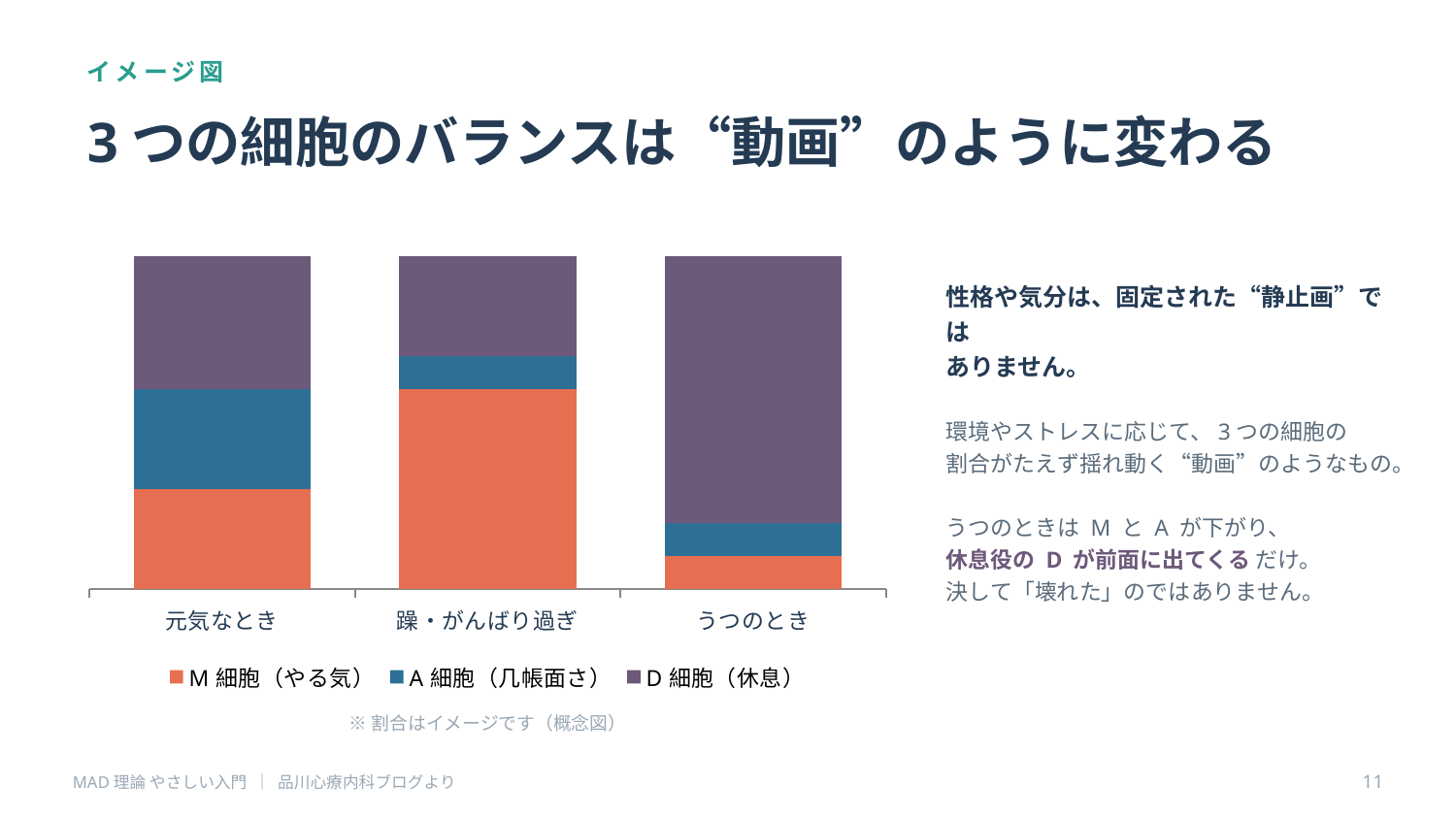
Which category has the largest D 細胞（休息） segment? うつのとき Which category has the smallest M 細胞（やる気） segment? うつのとき Which category has the smallest D 細胞（休息） segment? 躁・がんばり過ぎ Is the M 細胞（やる気） segment larger in 元気なとき or in うつのとき? 元気なとき What kind of chart is shown on the slide? stacked bar chart Which category has the largest M 細胞（やる気） segment? 躁・がんばり過ぎ How many categories are shown on the x axis of the chart? 3 Is the D 細胞（休息） segment larger in 元気なとき or in 躁・がんばり過ぎ? 元気なとき What is the label of the third category on the x axis? うつのとき Which series is shown in orange in the chart's legend? M 細胞（やる気） How many series does the chart's legend list? 3 Which category has the largest A 細胞（几帳面さ） segment? 元気なとき